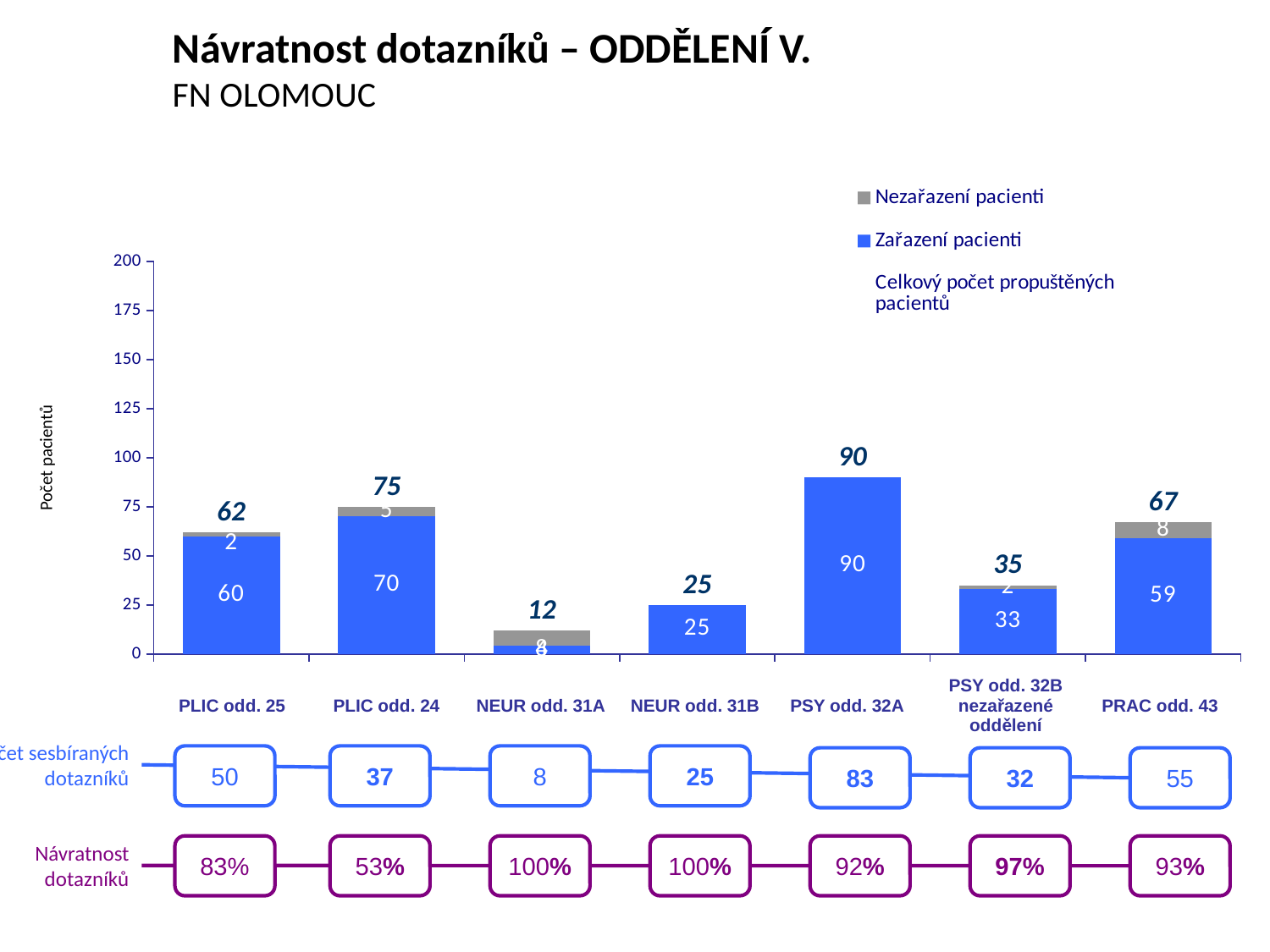
Is the total for PSY odd. 32B nezařazené oddělení greater or less than 50? less How many entries does the chart legend list? 3 What is the label of the vertical axis of the chart? Počet pacientů Which department has the lowest total number of discharged patients? NEUR odd. 31A What is the value of Zařazení pacienti for PLIC odd. 24? 70 What is the total number of discharged patients (Celkový počet propuštěných pacientů) for PSY odd. 32A? 90 What is the difference between the total for PLIC odd. 24 and the total for PLIC odd. 25? 13 What is the value of Nezařazení pacienti for PRAC odd. 43? 8 What type of chart is shown on the slide? stacked bar chart Which is larger: the Zařazení pacienti value for PRAC odd. 43 or for PLIC odd. 25? PLIC odd. 25 How many departments are shown on the x axis of the chart? 7 Which department has the highest total number of discharged patients? PSY odd. 32A